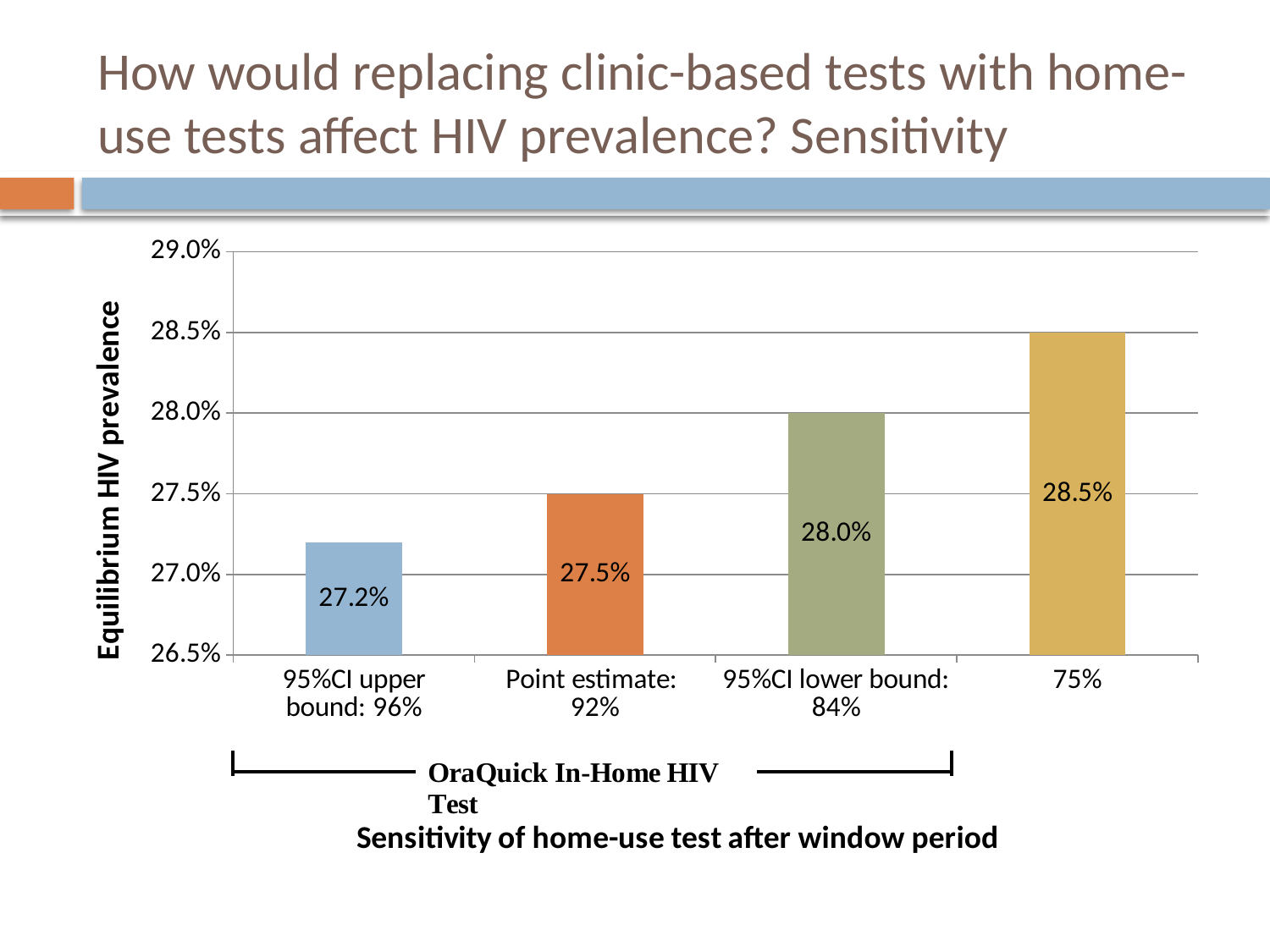
How many categories are shown on the x axis? 4 What is the difference in equilibrium HIV prevalence between the '75%' category and the '95%CI upper bound: 96%' category? 1.3% Which has a higher equilibrium HIV prevalence: 'Point estimate: 92%' or '95%CI lower bound: 84%'? 95%CI lower bound: 84% Which category has the highest equilibrium HIV prevalence? 75% Do the values rise or fall from left to right along the x axis? Rise What is the equilibrium HIV prevalence for the '95%CI upper bound: 96%' category? 27.2% What is the equilibrium HIV prevalence for the '75%' sensitivity category? 28.5% What kind of chart is shown on the slide? Bar chart Which category has the lowest equilibrium HIV prevalence? 95%CI upper bound: 96% What is the label of the y axis? Equilibrium HIV prevalence What is the equilibrium HIV prevalence for the '95%CI lower bound: 84%' category? 28.0% What is the equilibrium HIV prevalence for the 'Point estimate: 92%' category? 27.5%